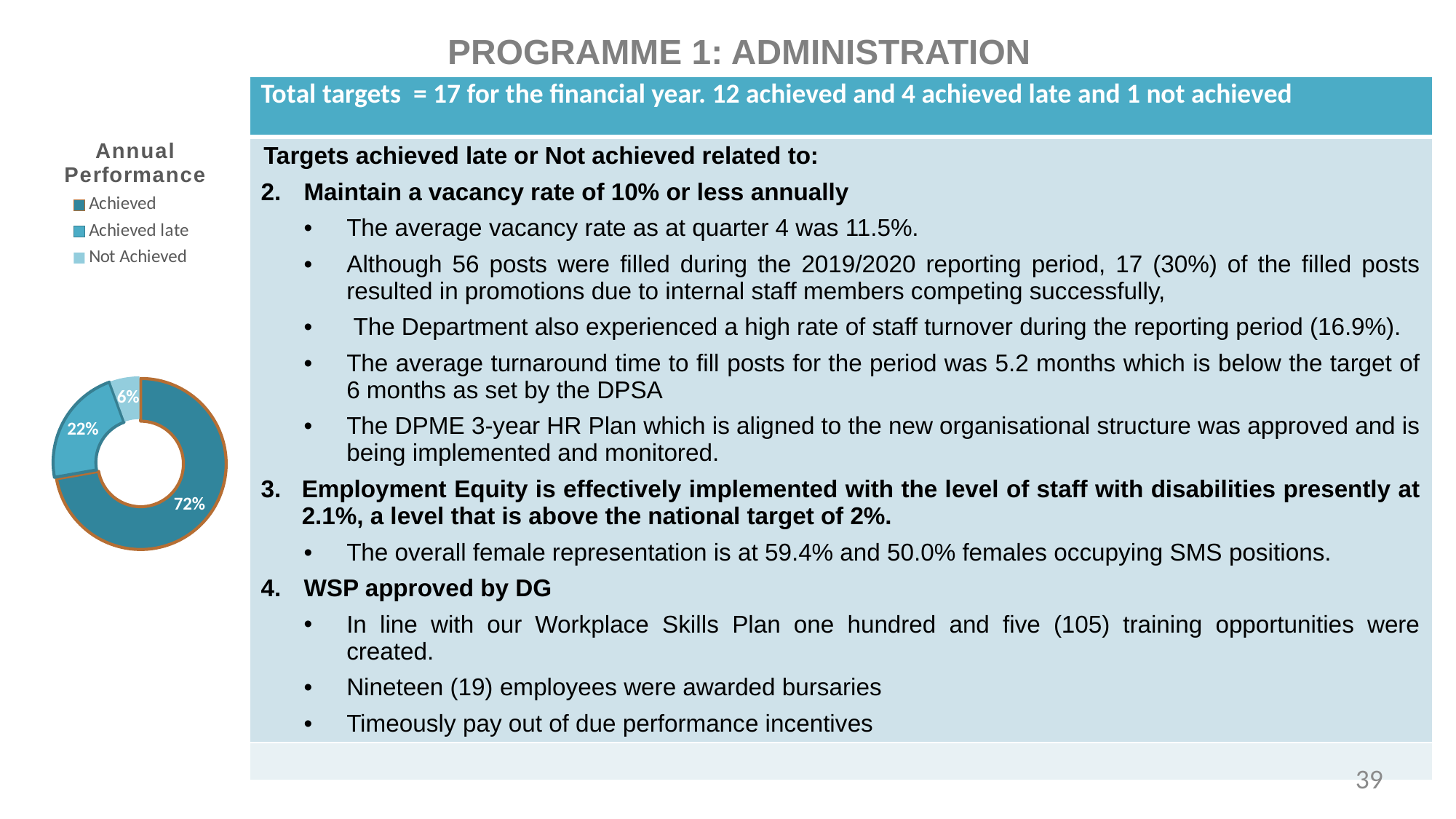
What is the difference in percentage points between the 'Achieved' and 'Achieved late' shares in the Annual Performance chart? 50 percentage points Which category has the largest share in the Annual Performance chart? Achieved What kind of chart is shown under the title 'Annual Performance'? Doughnut (pie) chart What percentage of the Annual Performance chart is labelled 'Achieved'? 72% What is the difference in percentage points between the 'Achieved late' and 'Not Achieved' shares in the Annual Performance chart? 16 percentage points Which legend entry in the Annual Performance chart is shown in the lightest blue colour? Not Achieved How many categories does the legend of the Annual Performance chart list? 3 Which category has the smallest share in the Annual Performance chart? Not Achieved Which is larger in the Annual Performance chart, the 'Achieved late' share or the 'Not Achieved' share? Achieved late What percentage of the Annual Performance chart is labelled 'Achieved late'? 22% What is the title of the chart on the slide? Annual Performance What percentage of the Annual Performance chart is labelled 'Not Achieved'? 6%